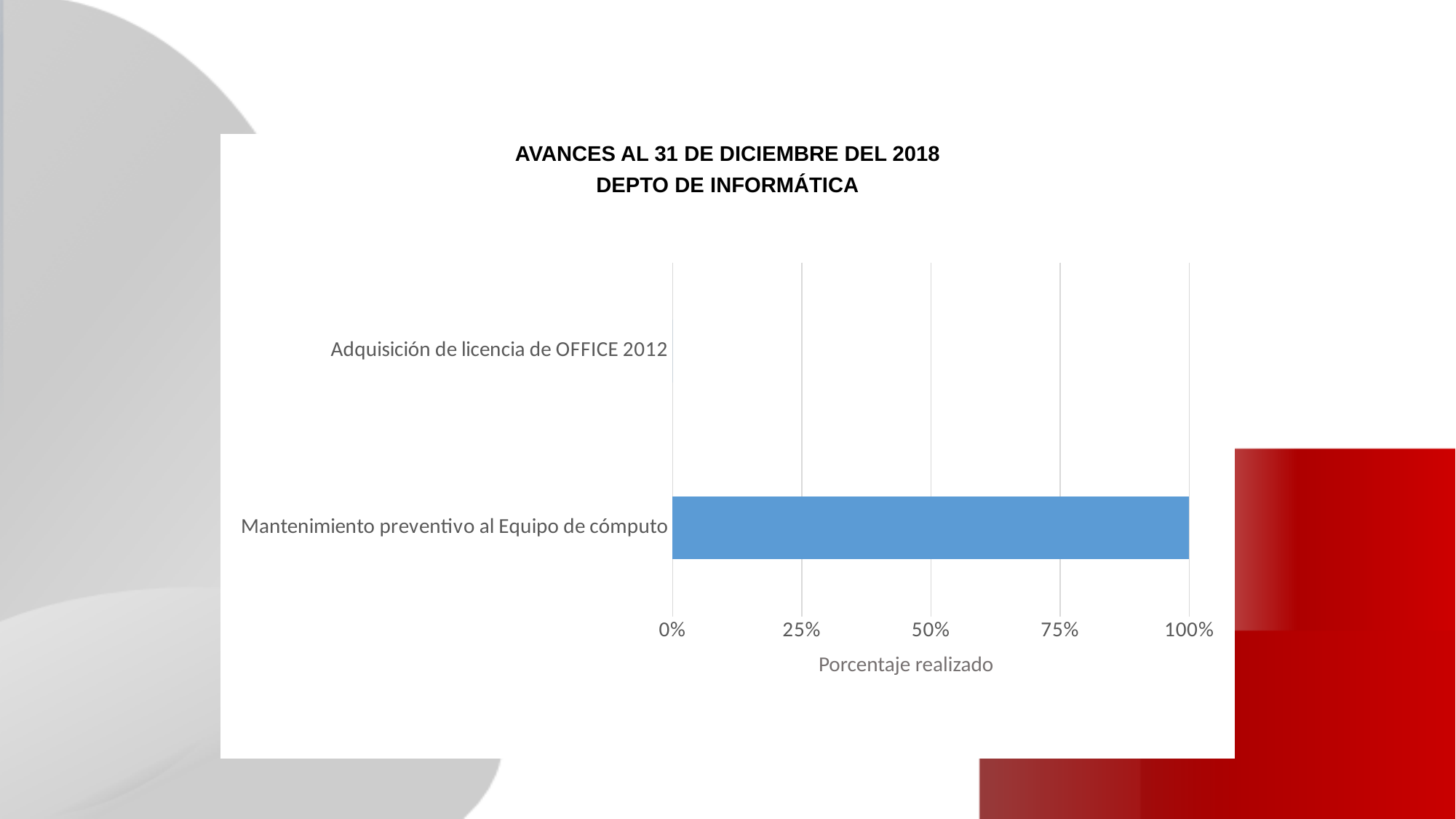
Is the value for Mantenimiento preventivo al Equipo de cómputo greater or less than 75%? greater How many categories are plotted on the chart? 2 What is the value for Mantenimiento preventivo al Equipo de cómputo? 100% Which category has the lowest value? Adquisición de licencia de OFFICE 2012 What kind of chart is shown on the slide? bar chart Which is larger, the value for Mantenimiento preventivo al Equipo de cómputo or the value for Adquisición de licencia de OFFICE 2012? Mantenimiento preventivo al Equipo de cómputo What is the title of the chart? AVANCES AL 31 DE DICIEMBRE DEL 2018 DEPTO DE INFORMÁTICA Is the value for Adquisición de licencia de OFFICE 2012 greater or less than 25%? less Which category has the highest value? Mantenimiento preventivo al Equipo de cómputo What is the label of the horizontal axis? Porcentaje realizado